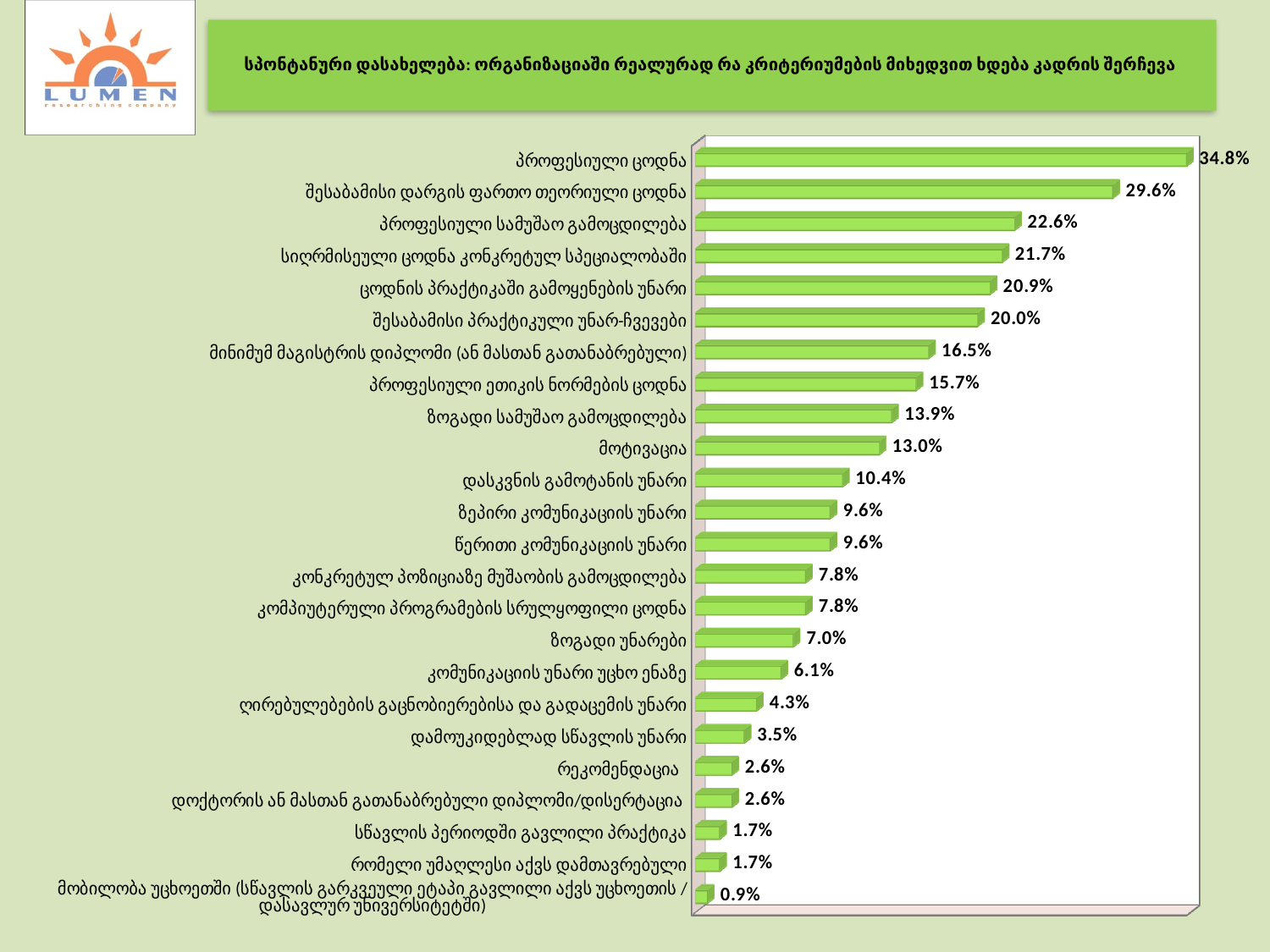
What is the difference between the values for პროფესიული ცოდნა and შესაბამისი დარგის ფართო თეორიული ცოდნა? 5.2% What is the value for პროფესიული ცოდნა? 34.8% What is the value for ზოგადი უნარები? 7.0% What is the difference between the values for პროფესიული სამუშაო გამოცდილება and ზოგადი სამუშაო გამოცდილება? 8.7% Which is larger, the value for მოტივაცია or the value for დასკვნის გამოტანის უნარი? მოტივაცია What is the value for მოტივაცია? 13.0% Which category has the highest value? პროფესიული ცოდნა How many categories are shown in the chart? 24 What kind of chart is shown on the slide? bar chart Which category has the lowest value? მობილობა უცხოეთში (სწავლის გარკვეული ეტაპი გავლილი აქვს უცხოეთის / დასავლურ უნივერსიტეტში) What colour are the bars in the chart? green What is the value for რეკომენდაცია? 2.6%